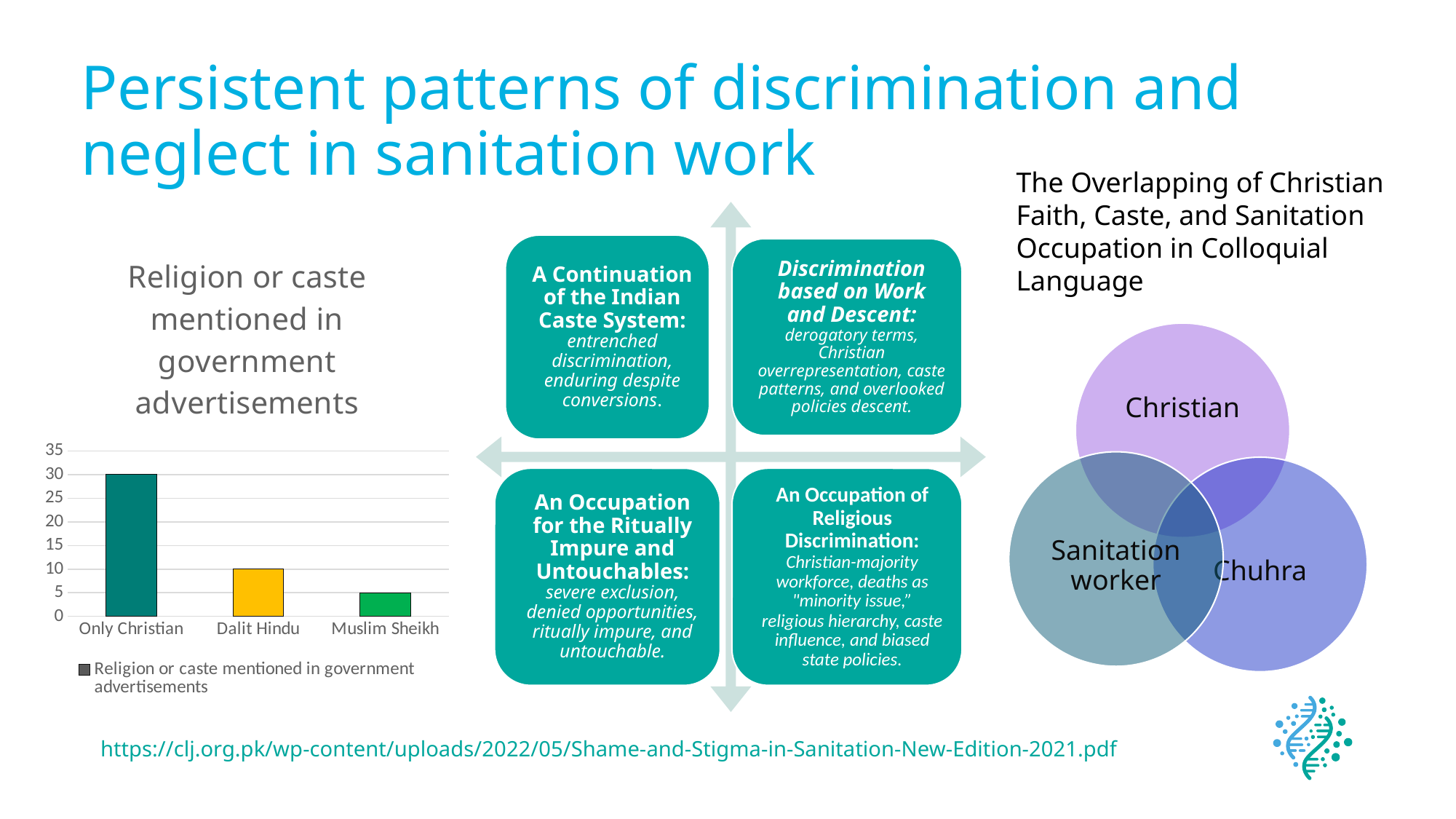
How many categories are shown on the x axis of the bar chart? 3 What is the value for Dalit Hindu in the bar chart? 10 Which is larger in the bar chart, Dalit Hindu or Muslim Sheikh? Dalit Hindu Is the value for Only Christian greater or less than 25? greater What is the difference between the values for Only Christian and Dalit Hindu? 20 How many series does the legend of the bar chart list? 1 What is the value for Muslim Sheikh in the bar chart? 5 What kind of chart is used to show religion or caste mentioned in government advertisements? bar chart What is the value for Only Christian in the bar chart? 30 What is the title of the bar chart? Religion or caste mentioned in government advertisements Which category has the highest value in the bar chart? Only Christian Which category has the lowest value in the bar chart? Muslim Sheikh